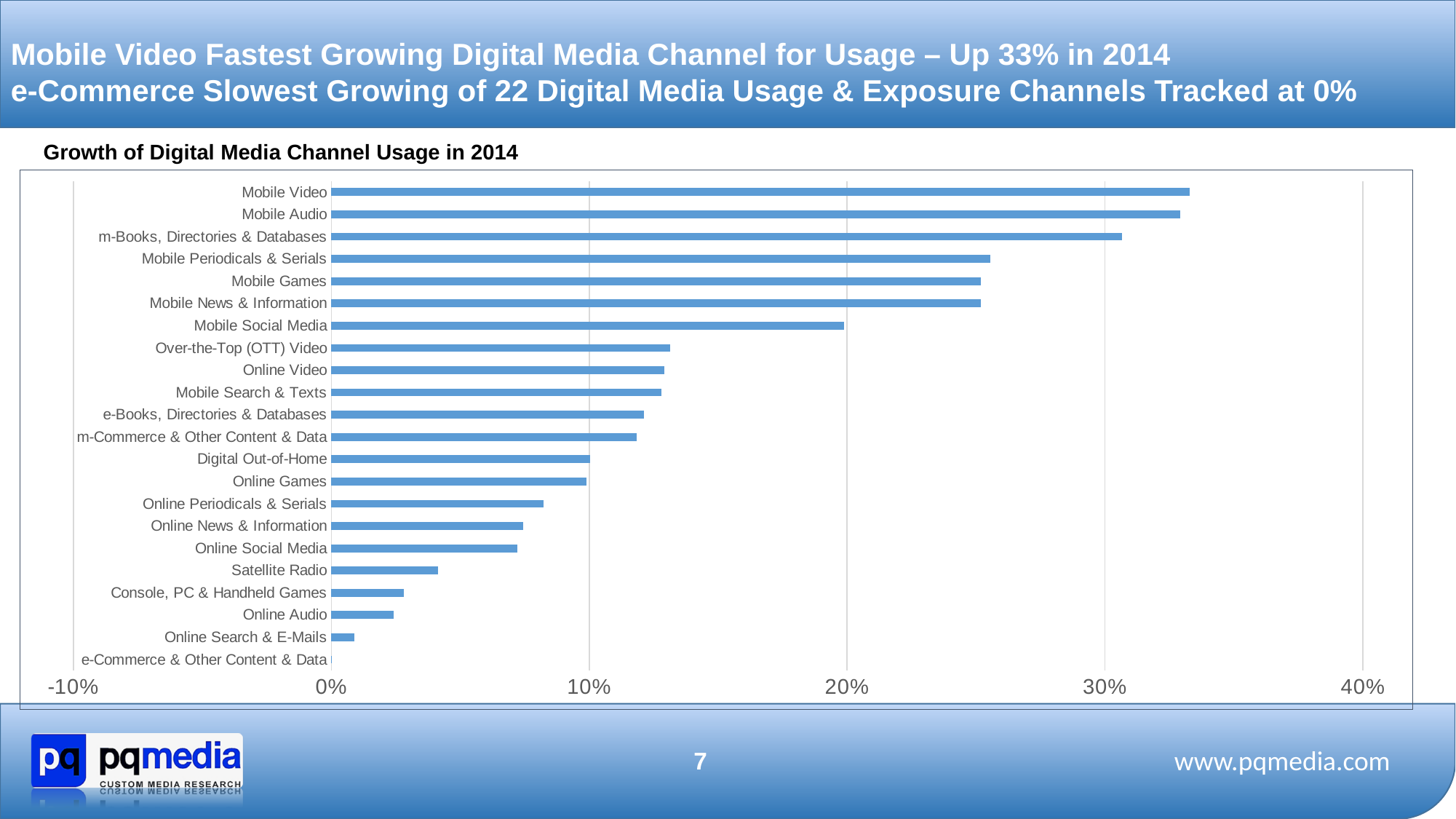
Is the value for Mobile Games greater or less than 20%? greater Which is larger, the value for Mobile Audio or the value for Mobile Social Media? Mobile Audio What is the title of the chart? Growth of Digital Media Channel Usage in 2014 According to the slide, what was the growth of Mobile Video usage in 2014? 33% Is the value for Online Social Media greater or less than 10%? less Which channel has the highest growth in the chart? Mobile Video How many digital media channels are plotted in the chart? 22 What kind of chart is shown on the slide? bar chart According to the slide, what was the growth of e-Commerce & Other Content & Data in 2014? 0% Which channel has the lowest growth in the chart? e-Commerce & Other Content & Data Which is larger, the value for Online Video or the value for Online Audio? Online Video Is the value for Satellite Radio greater or less than 10%? less